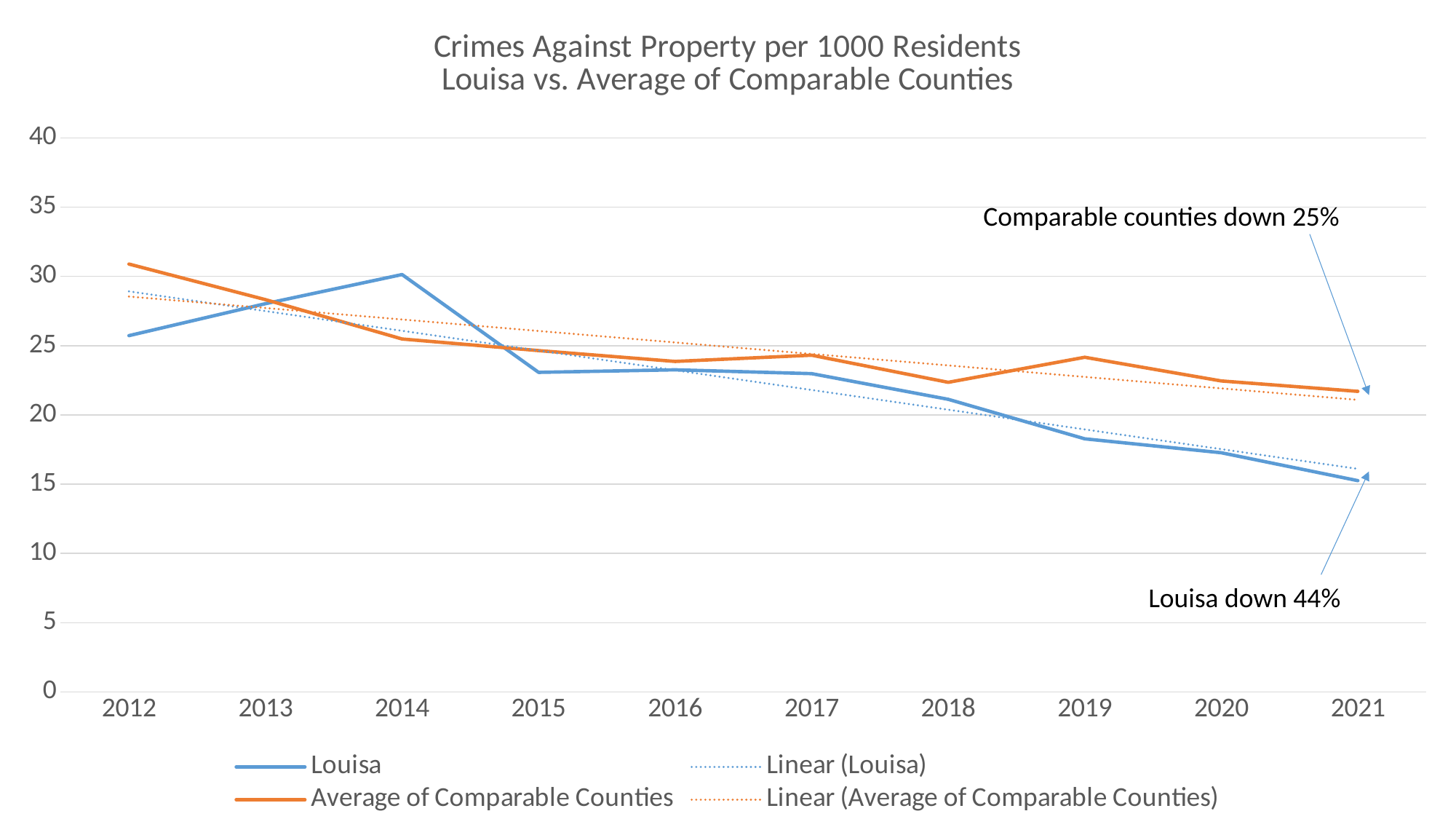
In 2019, which is larger: Louisa or Average of Comparable Counties? Average of Comparable Counties What kind of chart is shown on the slide? Line chart According to the annotation on the chart, by what percentage is Louisa down? 44% Is the value for Louisa in 2021 greater or less than 20? less In which year is the Average of Comparable Counties line at its highest? 2012 How many years are plotted along the x axis? 10 In 2014, which is larger: Louisa or Average of Comparable Counties? Louisa Does the Louisa line rise or fall overall from 2012 to 2021? Fall In which year does the Louisa line reach its highest value? 2014 How many entries does the legend list? 4 Is the value for Average of Comparable Counties in 2012 greater or less than 30? greater In which year does the Louisa line reach its lowest value? 2021